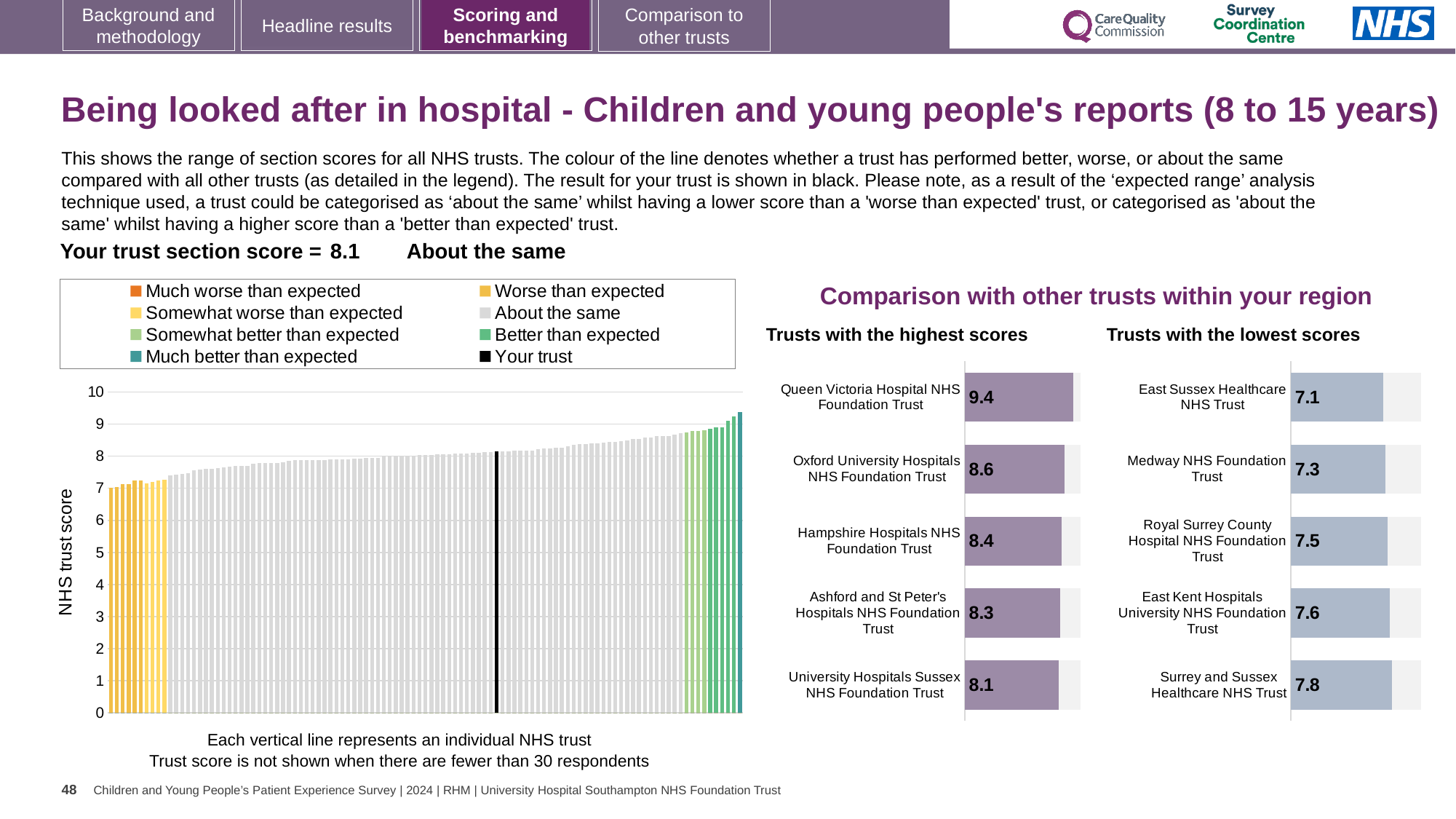
How many trusts are listed in the 'Trusts with the lowest scores' chart? 5 In the 'Trusts with the highest scores' chart, what is the score for Queen Victoria Hospital NHS Foundation Trust? 9.4 How many entries does the legend of the 'NHS trust score' chart list? 8 In the 'NHS trust score' chart, is the value of the tallest bar on the far right greater or less than 9? greater In the 'Trusts with the lowest scores' chart, which trust has the lowest score? East Sussex Healthcare NHS Trust In the 'NHS trust score' chart, what colour is used to show 'Your trust'? Black What type of chart is the 'NHS trust score' chart on the left of the slide? Bar chart In the 'Trusts with the highest scores' chart, what is the difference between the scores of Queen Victoria Hospital NHS Foundation Trust and Oxford University Hospitals NHS Foundation Trust? 0.8 In the 'NHS trust score' chart, do the bar values rise or fall from left to right? Rise In the 'Trusts with the lowest scores' chart, which has the higher score: Royal Surrey County Hospital NHS Foundation Trust or East Kent Hospitals University NHS Foundation Trust? East Kent Hospitals University NHS Foundation Trust In the 'Trusts with the highest scores' chart, which trust has the lowest score shown? University Hospitals Sussex NHS Foundation Trust In the 'Trusts with the lowest scores' chart, what is the score for Medway NHS Foundation Trust? 7.3